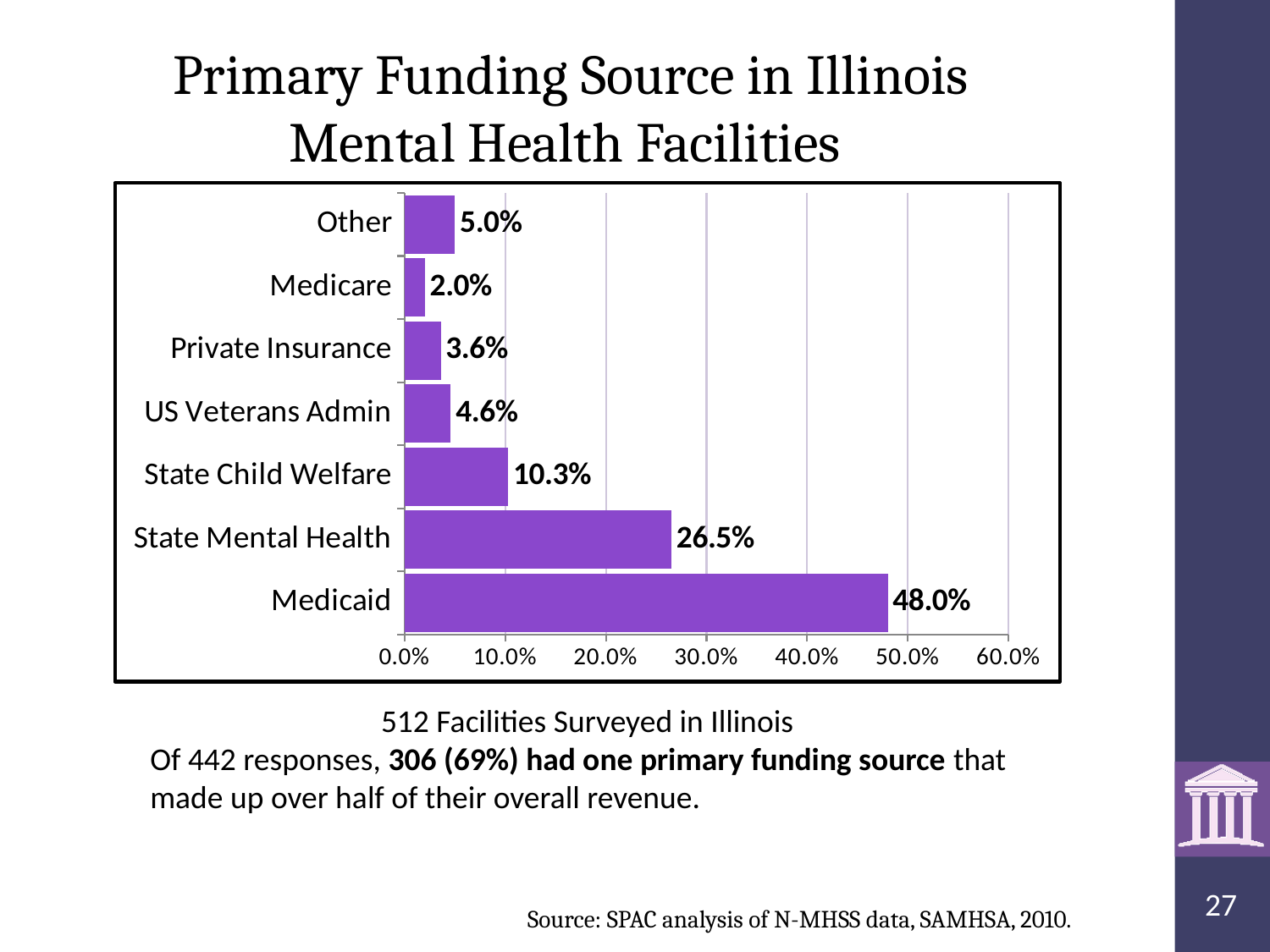
What is the title of the chart on the slide? Primary Funding Source in Illinois Mental Health Facilities What is the value for State Child Welfare? 10.3% What kind of chart is shown on the slide? bar chart What is the difference between the values for Medicaid and State Mental Health? 21.5% Which funding source has the highest value? Medicaid Is the value for State Mental Health greater or less than 30.0%? less What is the difference between the values for Other and Private Insurance? 1.4% What is the value for Medicaid? 48.0% Which is larger, the value for US Veterans Admin or the value for Private Insurance? US Veterans Admin Which funding source has the lowest value? Medicare What is the value for US Veterans Admin? 4.6% How many funding source categories are shown in the chart? 7